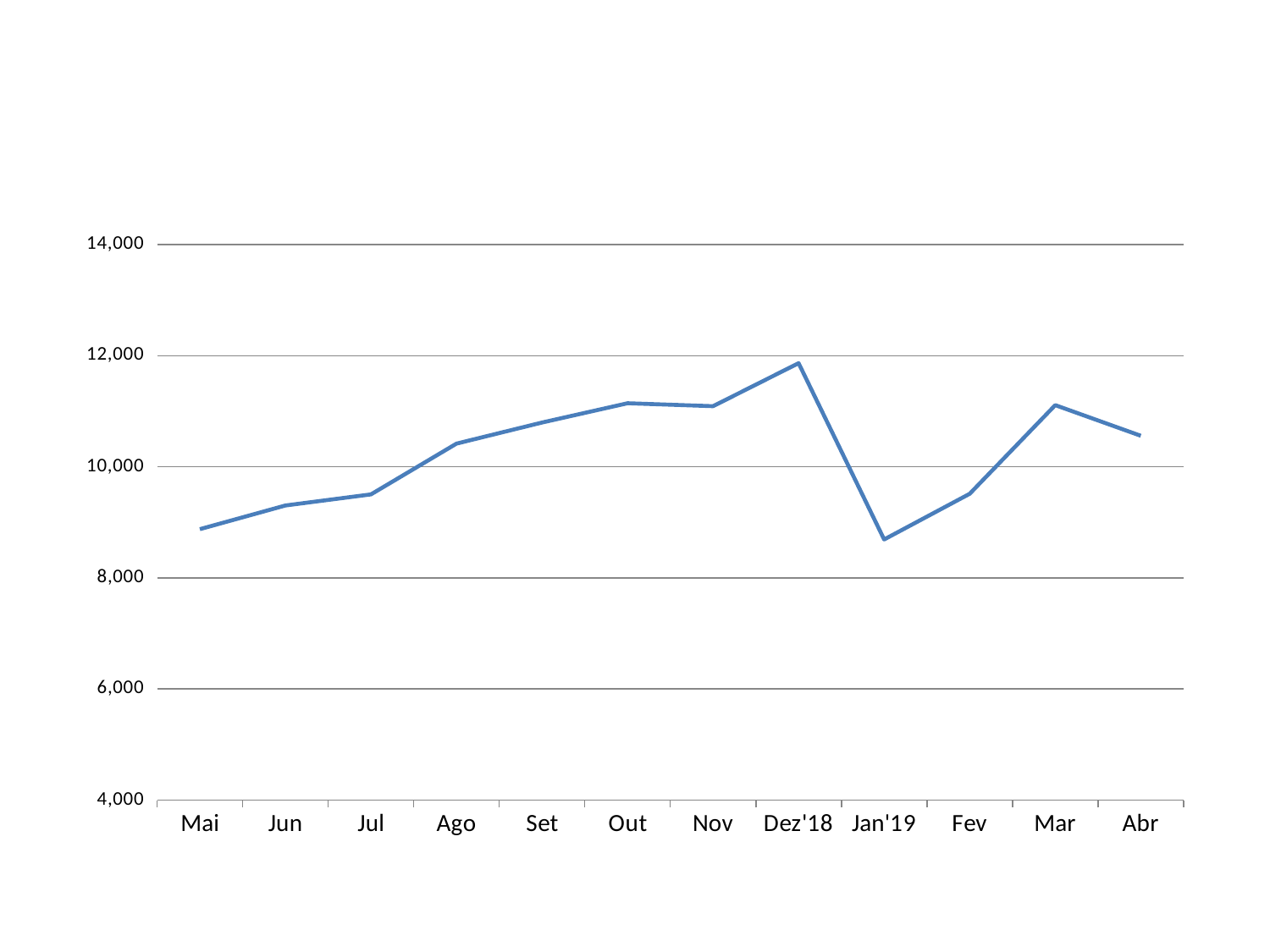
Is the value for Mai greater or less than 10,000? less Is the value for Jan'19 greater or less than 10,000? less Is the value for Dez'18 greater or less than 10,000? greater Which month has the lowest value? Jan'19 How many months are plotted along the x axis? 12 Do the values rise or fall from Mai to Dez'18? rise Which month has the highest value? Dez'18 Which is larger, the value for Ago or the value for Jul? Ago What colour is the plotted line? blue What kind of chart is shown on the slide? line chart